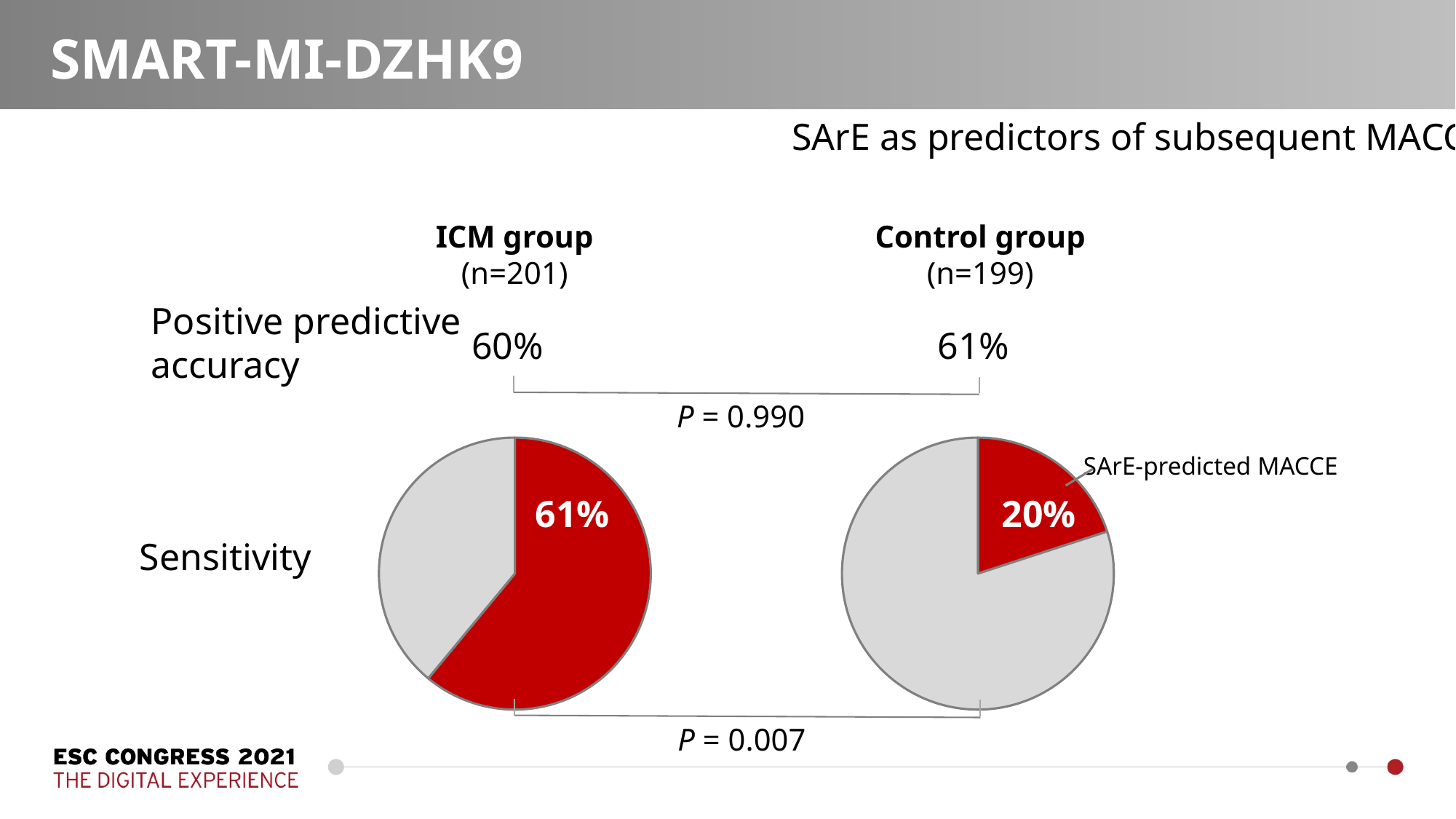
How many slices does each pie chart have? 2 Which pie chart has the larger SArE-predicted MACCE slice, the ICM group or the Control group? ICM group Is the red slice in the Control group pie chart greater or less than 50% of the pie? less What colour is the SArE-predicted MACCE slice in the pie charts? Red In the Control group pie chart, what share is labelled as SArE-predicted MACCE? 20% What kind of charts are shown on the slide? Pie charts What is the difference between the sensitivity shown in the ICM group pie chart and the Control group pie chart? 41% In the ICM group pie chart, what share is labelled as SArE-predicted MACCE? 61% Is the red slice in the ICM group pie chart greater or less than 50% of the pie? greater What is the sample size of the group shown in the left pie chart (ICM group)? n=201 How many pie charts are on the slide? 2 What P value is shown beneath the two sensitivity pie charts? P = 0.007